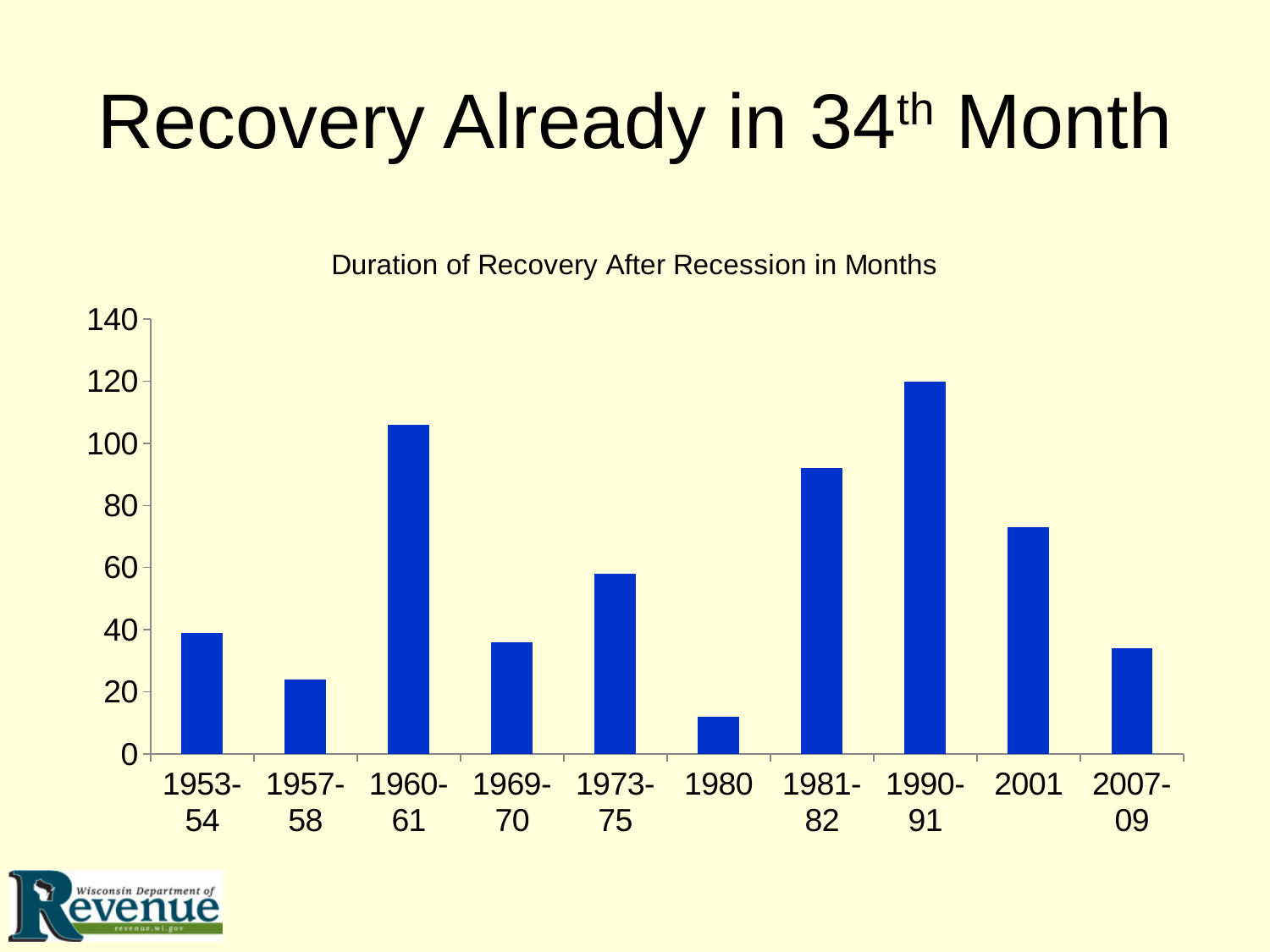
How many recession periods are shown on the x axis of the chart? 10 Which has a longer recovery duration, 1973-75 or 2001? 2001 Is the recovery duration for 2001 greater or less than 60 months? greater What type of chart is shown on the slide? bar chart Is the recovery duration for 1981-82 greater or less than 80 months? greater Which recession period has the shortest recovery duration? 1980 Which recession period has the longest recovery duration? 1990-91 Is the recovery duration for 1980 greater or less than 20 months? less What is the title of the chart? Duration of Recovery After Recession in Months Which has a longer recovery duration, 1957-58 or 1969-70? 1969-70